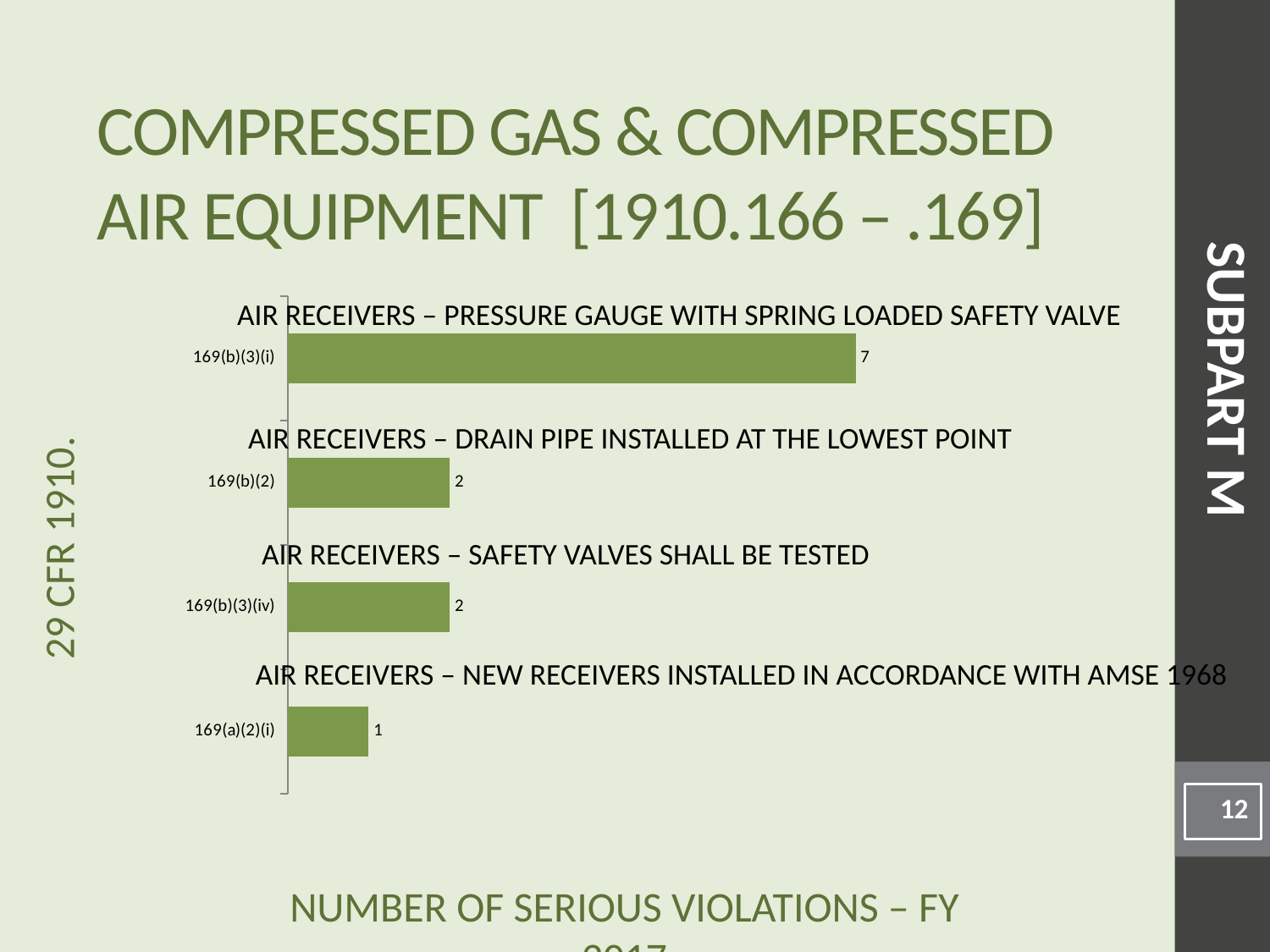
What is the value for 169(b)(3)(iv)? 2 What colour are the bars in the chart? Green What is the value for 169(b)(3)(i)? 7 Which is larger, the value for 169(b)(3)(iv) or the value for 169(a)(2)(i)? 169(b)(3)(iv) Which category has the highest value? 169(b)(3)(i) How many categories are shown in the chart? 4 What is the difference between the values for 169(b)(3)(i) and 169(b)(2)? 5 What is the value for 169(b)(2)? 2 Which category has the lowest value? 169(a)(2)(i) What is the total of all the values shown in the chart? 12 What kind of chart is shown on the slide? Bar chart What is the value for 169(a)(2)(i)? 1